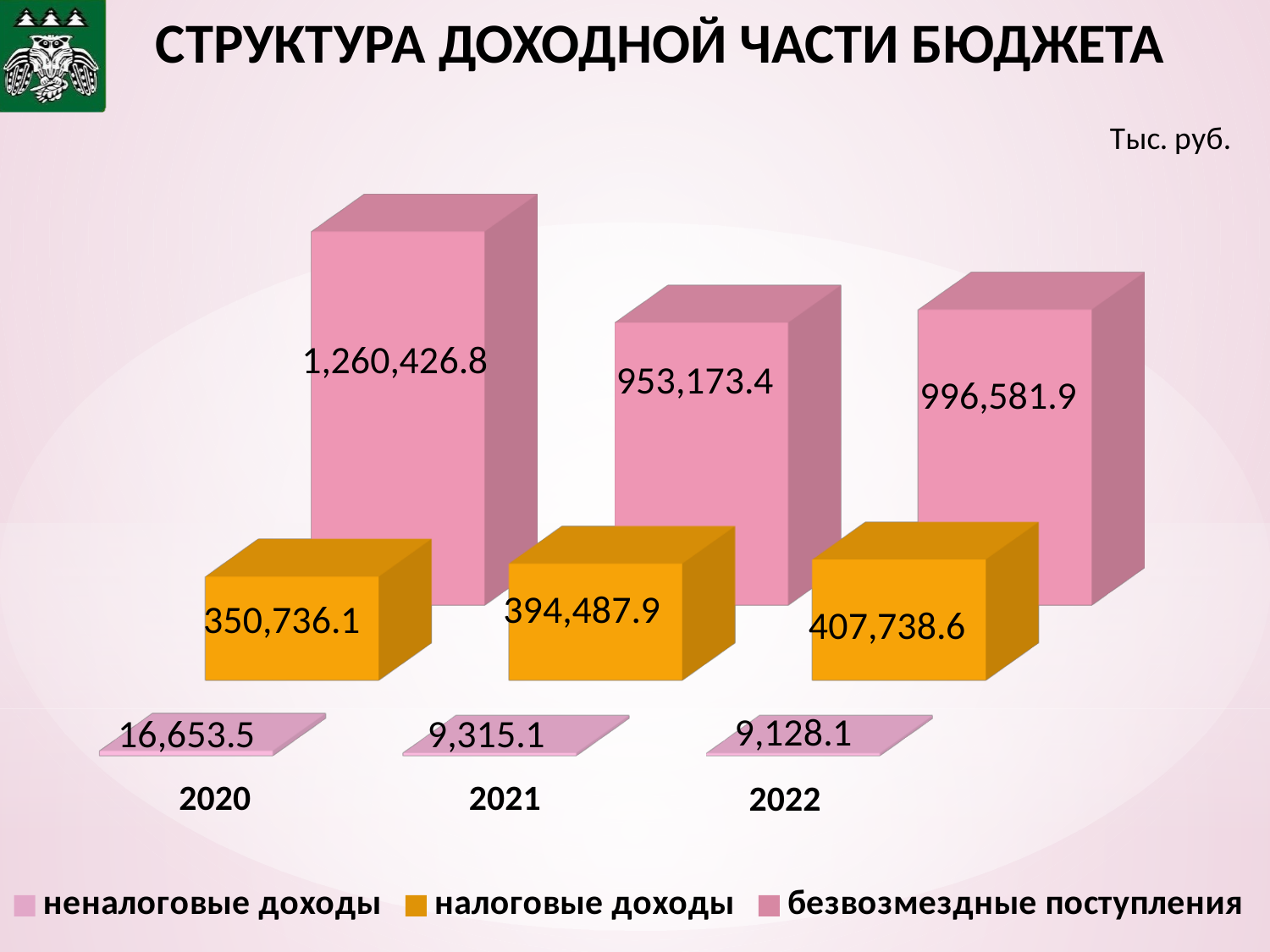
What is the value for налоговые доходы in 2021? 394,487.9 Which is larger: безвозмездные поступления in 2021 or in 2022? 2022 What is the value for неналоговые доходы in 2022? 9,128.1 In which year are безвозмездные поступления highest? 2020 How many years are shown on the x axis? 3 What is the difference between безвозмездные поступления in 2020 and in 2021? 307,253.4 What is the value for безвозмездные поступления in 2020? 1,260,426.8 Do налоговые доходы rise or fall from 2020 to 2022? rise What is the difference between налоговые доходы in 2022 and in 2021? 13,250.7 In which year are налоговые доходы lowest? 2020 What kind of chart is shown on the slide? bar chart How many series does the legend list? 3